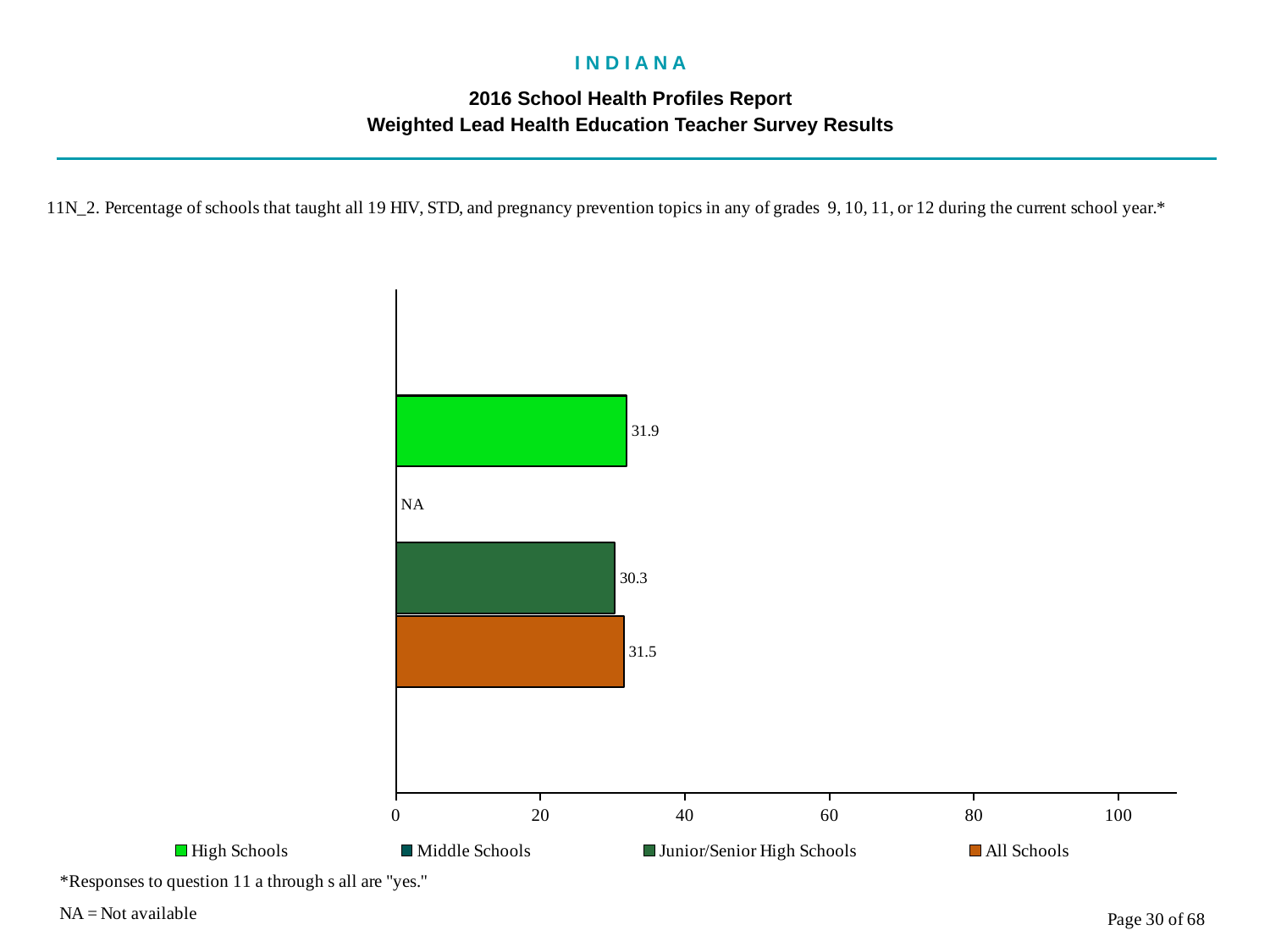
What is shown for Middle Schools? NA How many series does the legend list? 4 What is the value for All Schools? 31.5 What is the value for High Schools? 31.9 What is the value for Junior/Senior High Schools? 30.3 Is the value for High Schools greater or less than 40? less Which school type with a plotted value has the lowest value? Junior/Senior High Schools What is the difference between the High Schools value and the Junior/Senior High Schools value? 1.6 What kind of chart is shown? bar chart What colour is the All Schools bar? orange Which school type has the highest value? High Schools What is the difference between the All Schools value and the Junior/Senior High Schools value? 1.2